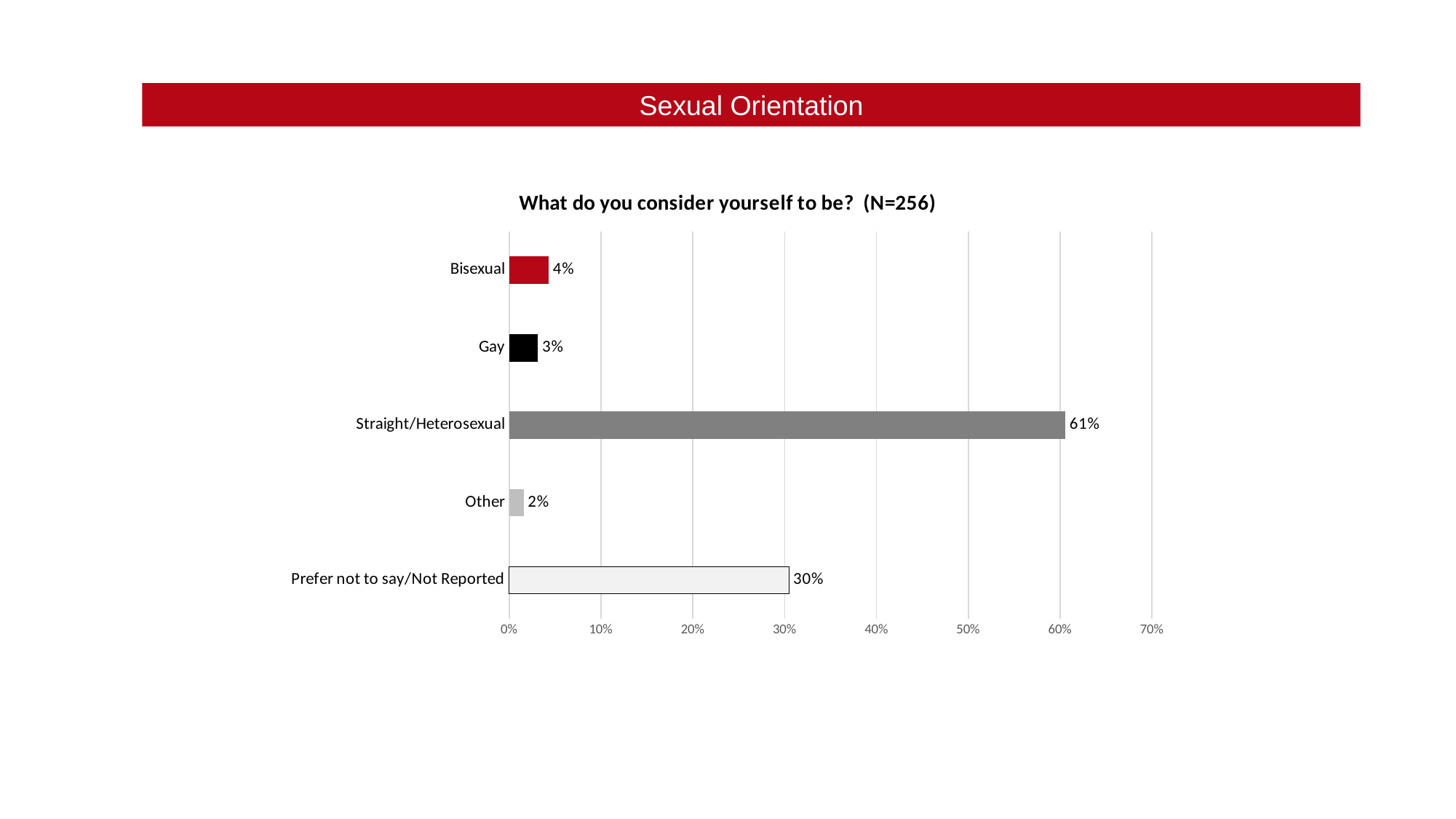
What percentage of respondents identified as Bisexual? 4% Which category has the highest percentage? Straight/Heterosexual Which is larger, the percentage for Bisexual or for Gay? Bisexual What percentage of respondents identified as Straight/Heterosexual? 61% Is the value for Straight/Heterosexual greater or less than 50%? greater Which category has the lowest percentage? Other How many categories are shown in the chart? 5 What percentage of respondents identified as Gay? 3% What is the sample size (N) stated in the chart title? 256 What type of chart is shown on the slide? Bar chart What is the difference in percentage points between Straight/Heterosexual and Prefer not to say/Not Reported? 31 What percentage of respondents chose Prefer not to say/Not Reported? 30%